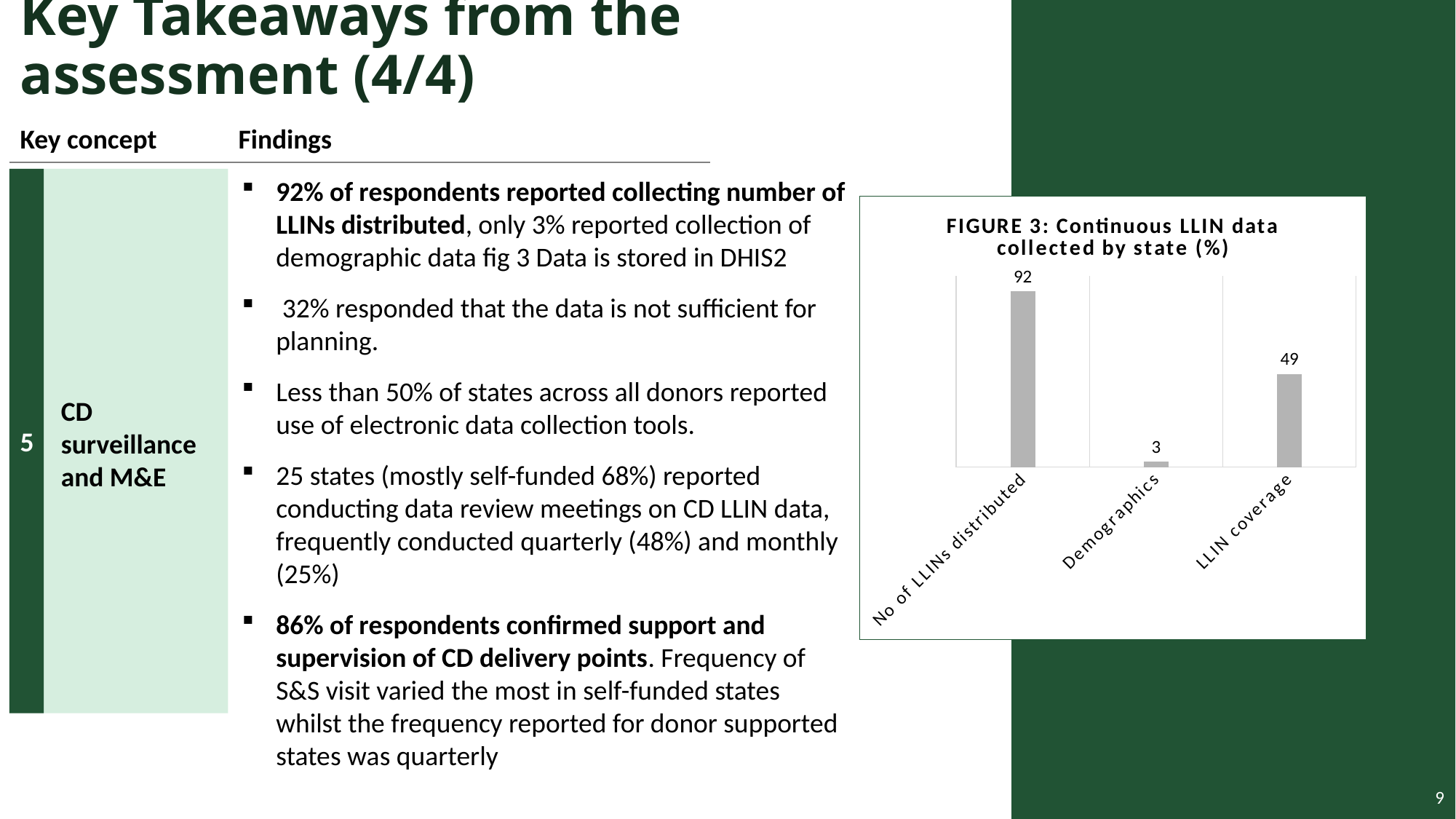
How many categories are plotted in the chart? 3 Which is larger: the value for 'LLIN coverage' or the value for 'Demographics'? LLIN coverage What kind of chart is shown on the slide? Bar chart What is the difference between the values for 'No of LLINs distributed' and 'LLIN coverage'? 43 What colour are the bars in the chart? Grey What is the difference between the values for 'LLIN coverage' and 'Demographics'? 46 Which category has the lowest value in the chart? Demographics What value is shown for 'Demographics' in the chart? 3 What is the title of the chart on the slide? FIGURE 3: Continuous LLIN data collected by state (%) Which category has the highest value in the chart? No of LLINs distributed What value is shown for 'LLIN coverage' in the chart? 49 What value is shown for 'No of LLINs distributed' in the chart? 92